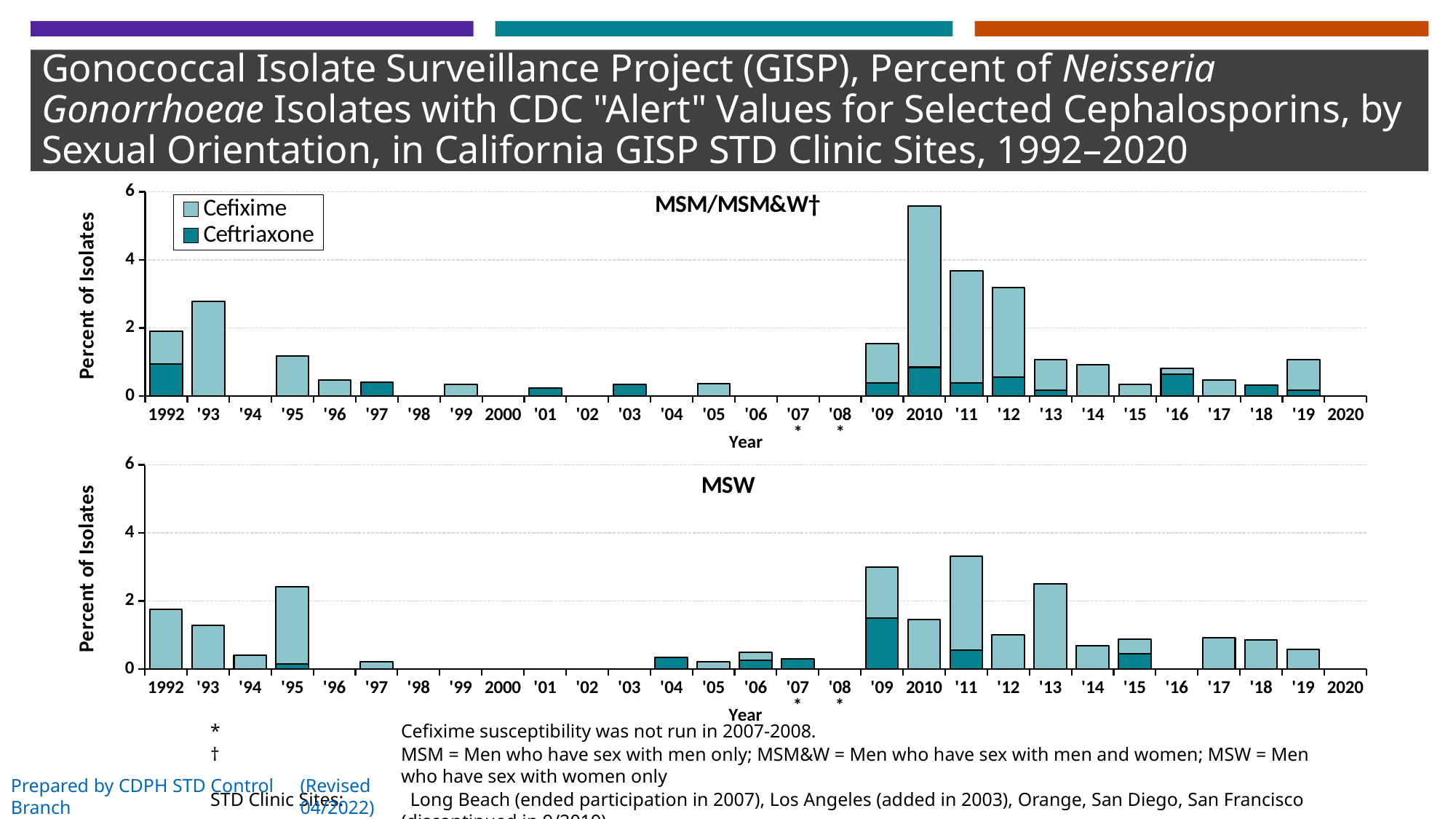
In the MSW chart, which year has the larger total, 2009 or 2010? 2009 In the MSW chart, is the total value for 2011 greater or less than 2? greater In the MSM/MSM&W† chart, which year has the larger total, 2010 or 2011? 2010 What is the title of the lower chart on the slide? MSW In the MSM/MSM&W† chart, is the total value for 1993 greater or less than 2? greater How many series does the legend on the MSM/MSM&W† chart list? 2 How many years are shown on the x axis of the MSW chart? 29 What kind of chart is the MSM/MSM&W† chart? Stacked bar chart In the MSM/MSM&W† chart, which year has the highest total percent of isolates? 2010 In the MSM/MSM&W† chart, is the total value for 2010 greater or less than 4? greater Which two antibiotics are listed in the legend of the MSM/MSM&W† chart? Cefixime and Ceftriaxone